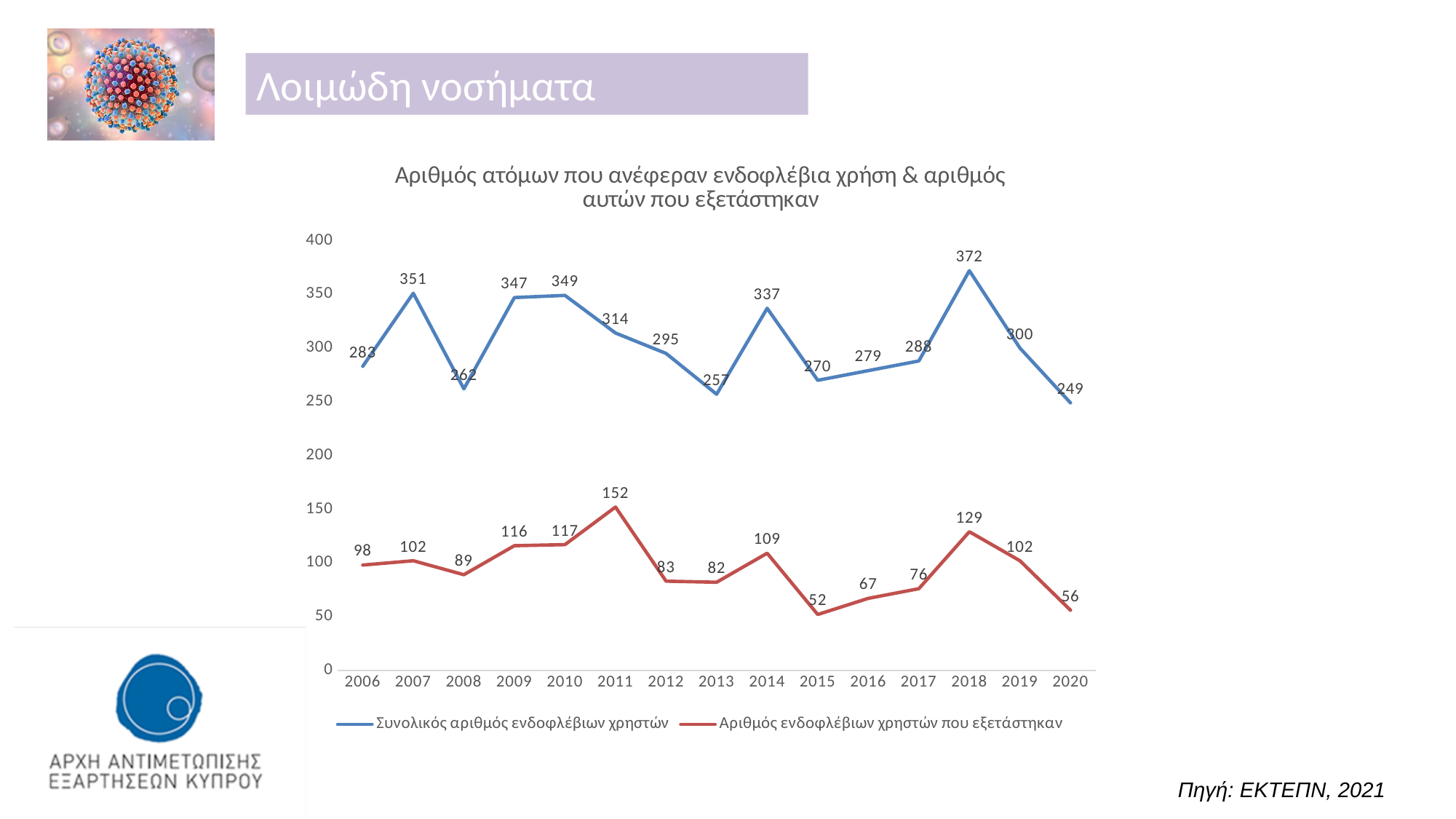
Which colour is used for the 'Αριθμός ενδοφλέβιων χρηστών που εξετάστηκαν' series? Red How many series does the legend list? 2 In which year is the 'Αριθμός ενδοφλέβιων χρηστών που εξετάστηκαν' series at its highest? 2011 What is the difference between the two series in 2020? 193 What type of chart is shown on the slide? Line chart In which year is the 'Συνολικός αριθμός ενδοφλέβιων χρηστών' series at its lowest? 2020 How many years are plotted along the x axis? 15 What is the value of the 'Συνολικός αριθμός ενδοφλέβιων χρηστών' series in 2018? 372 Which is larger for the 'Συνολικός αριθμός ενδοφλέβιων χρηστών' series: the value in 2007 or the value in 2014? 2007 In which year is the 'Αριθμός ενδοφλέβιων χρηστών που εξετάστηκαν' series at its lowest? 2015 What is the value of the 'Αριθμός ενδοφλέβιων χρηστών που εξετάστηκαν' series in 2011? 152 Does the 'Συνολικός αριθμός ενδοφλέβιων χρηστών' series rise or fall from 2018 to 2020? Fall